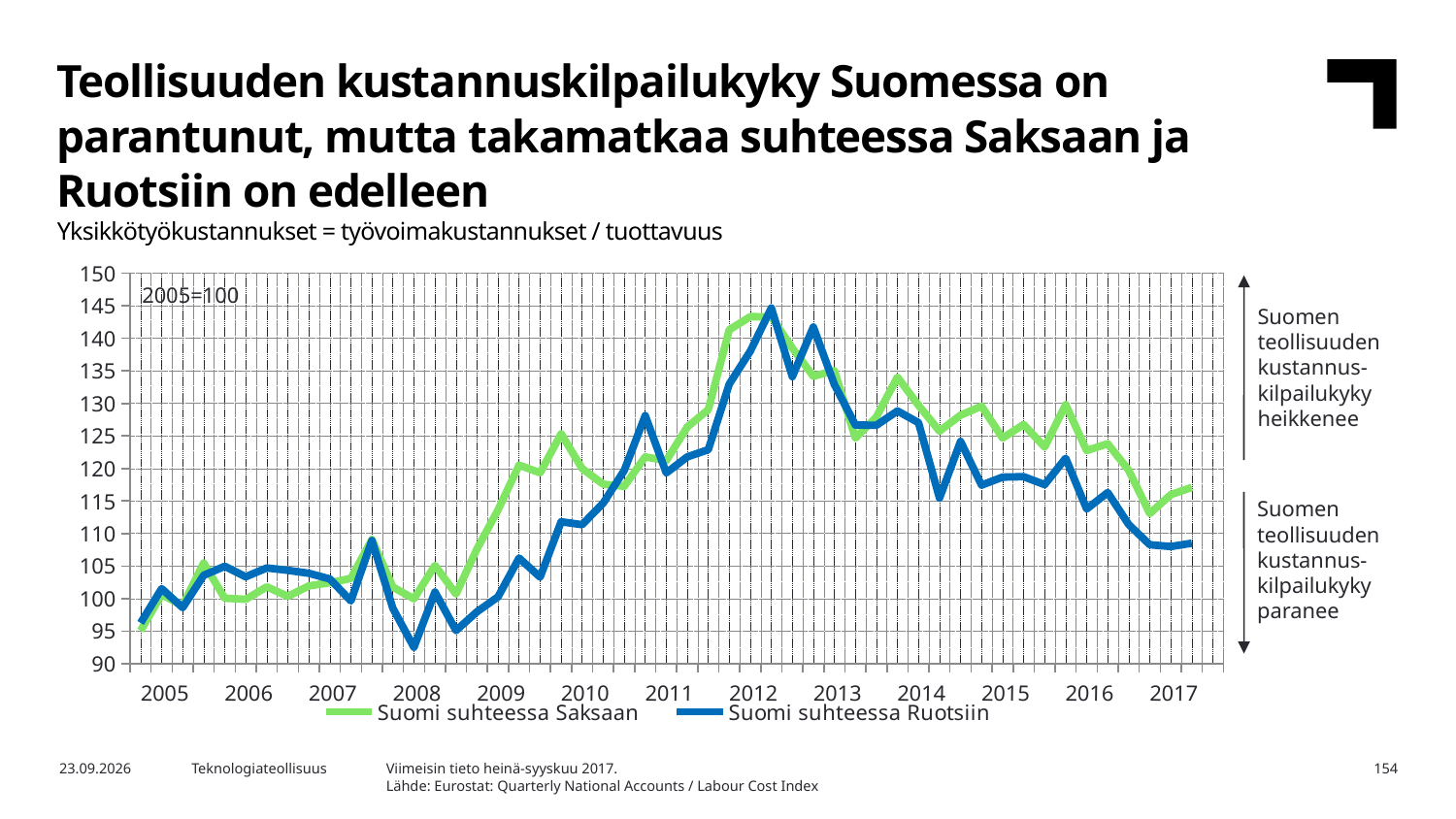
What base-year index is stated inside the chart area? 2005=100 Do both series generally rise or fall between 2012 and 2017? fall In which year does the 'Suomi suhteessa Saksaan' series reach its highest value? 2012 What are the two series named in the chart legend? Suomi suhteessa Saksaan; Suomi suhteessa Ruotsiin Is the last plotted value of 'Suomi suhteessa Ruotsiin' in 2017 greater or less than 110? less In which year does the 'Suomi suhteessa Ruotsiin' series reach its highest value? 2012 At the end of 2017, which series is higher: 'Suomi suhteessa Saksaan' or 'Suomi suhteessa Ruotsiin'? Suomi suhteessa Saksaan How many series does the chart legend list? 2 Is the peak value of 'Suomi suhteessa Ruotsiin' in 2012 greater or less than 140? greater Is the lowest value of 'Suomi suhteessa Ruotsiin' in 2008 greater or less than 95? less What kind of chart is shown on the slide? line chart How many year labels are shown on the x axis? 13